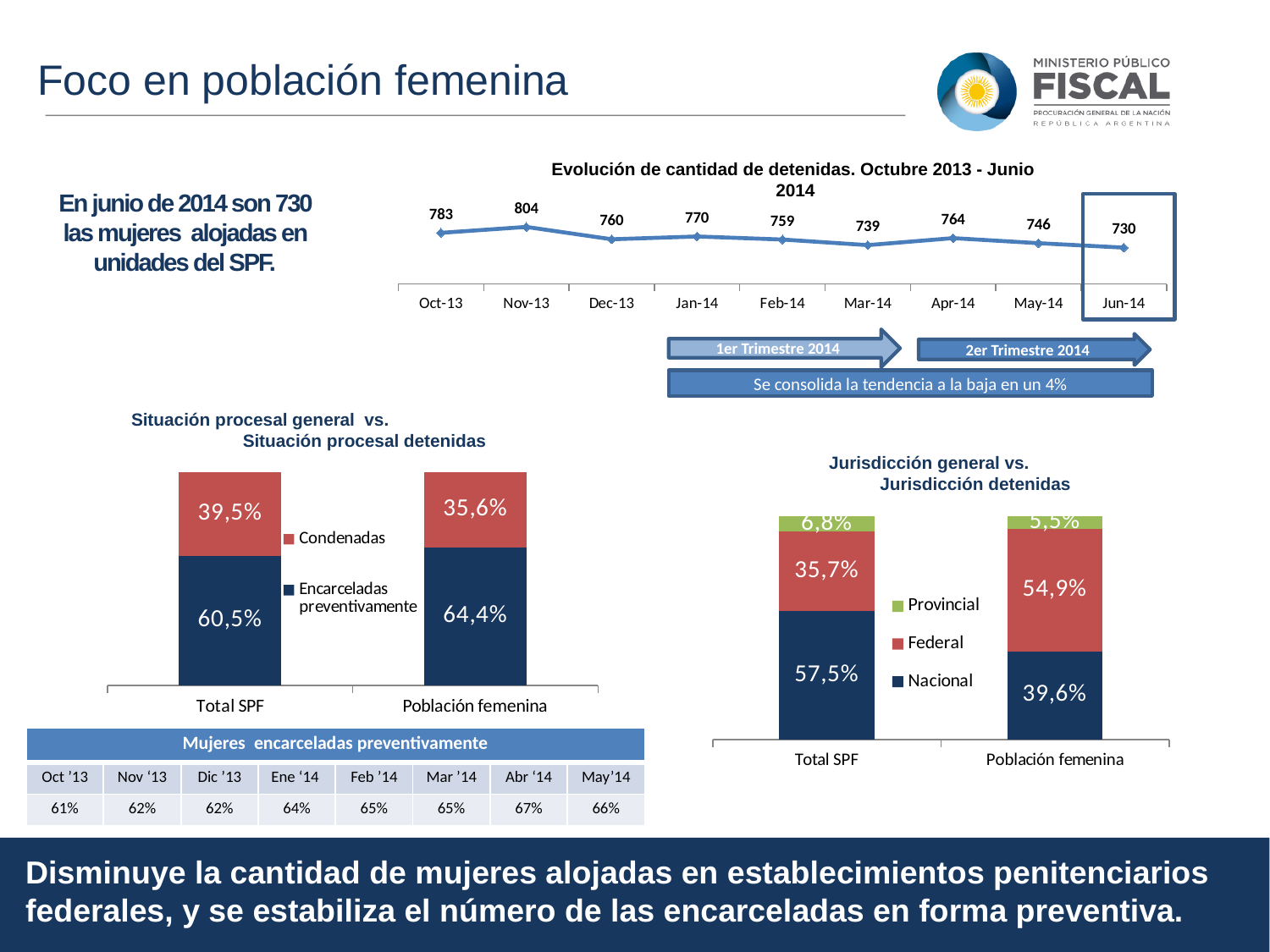
In the 'Evolución de cantidad de detenidas' line chart, what is the difference between the Oct-13 value and the Jun-14 value? 53 In the 'Jurisdicción general vs. Jurisdicción detenidas' chart, which is larger for Total SPF: Nacional or Federal? Nacional In the 'Jurisdicción general vs. Jurisdicción detenidas' chart, what is the Federal share for Población femenina? 54,9% In the 'Situación procesal general vs. Situación procesal detenidas' chart, what is the Encarceladas preventivamente share for Población femenina? 64,4% In the 'Situación procesal general vs. Situación procesal detenidas' chart, how many series does the legend list? 2 In the 'Evolución de cantidad de detenidas' line chart, do the values generally rise or fall from Oct-13 to Jun-14? fall What kind of chart is the 'Jurisdicción general vs. Jurisdicción detenidas' chart? stacked bar chart In the 'Situación procesal general vs. Situación procesal detenidas' chart, what is the Condenadas share for Total SPF? 39,5% In the 'Evolución de cantidad de detenidas' line chart, what is the value for Nov-13? 804 In the 'Evolución de cantidad de detenidas' line chart, which month has the highest value? Nov-13 In the 'Evolución de cantidad de detenidas' line chart, which month has the lowest value? Jun-14 In the 'Evolución de cantidad de detenidas' line chart, how many months are plotted? 9